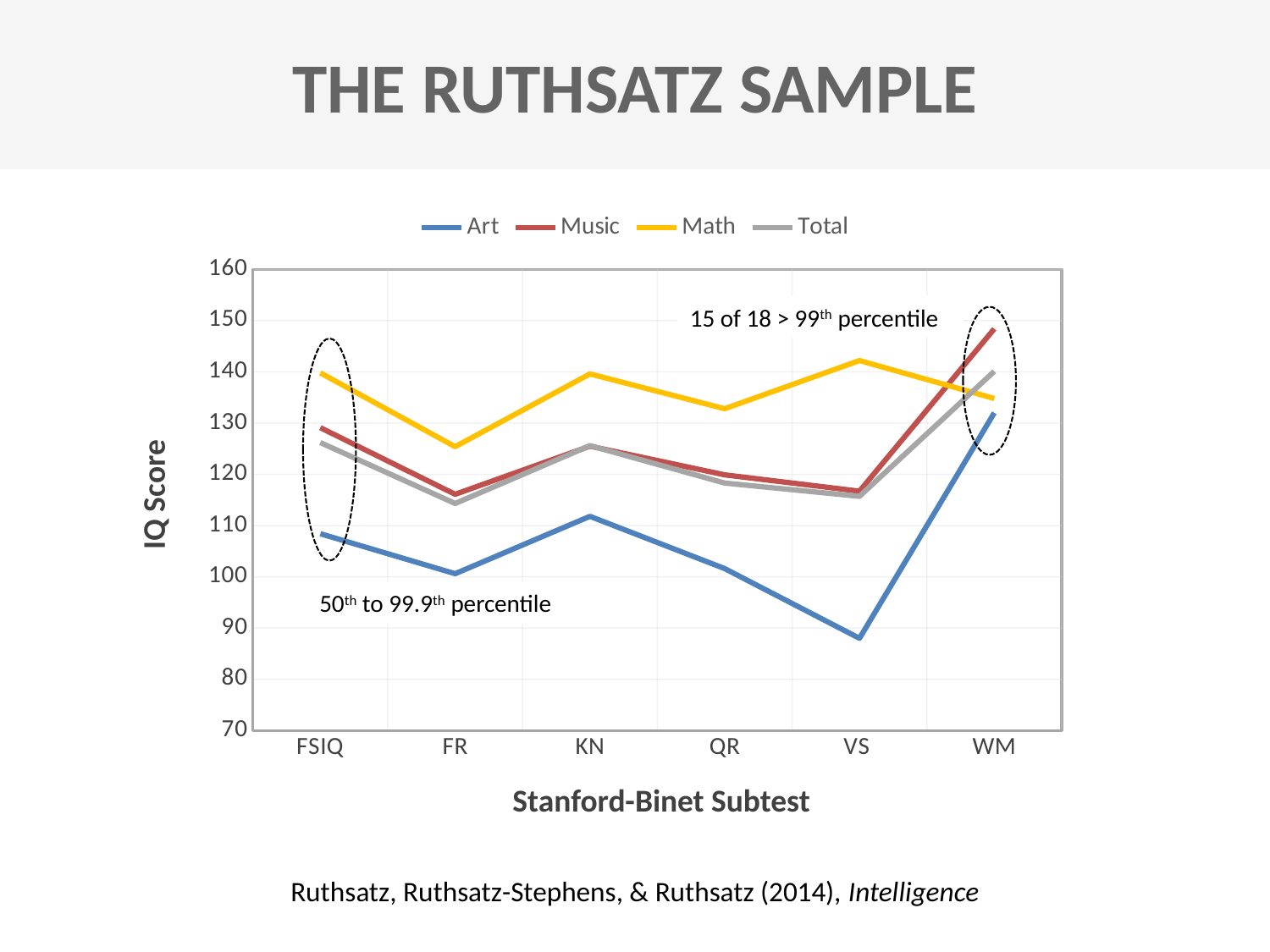
What is the title of the x axis? Stanford-Binet Subtest For which subtest is the Music series highest? WM For which subtest is the Art series lowest? VS At WM, which is larger, the Music value or the Total value? Music How many subtests are shown along the x axis? 6 Is the value for Math at FR greater or less than 130? less What kind of chart is shown on the slide? line chart Which series has the highest value at FSIQ? Math Does the Art series rise or fall from QR to VS? fall How many series does the legend list? 4 Is the value for Art at VS greater or less than 90? less Is the value for Music at WM greater or less than 140? greater